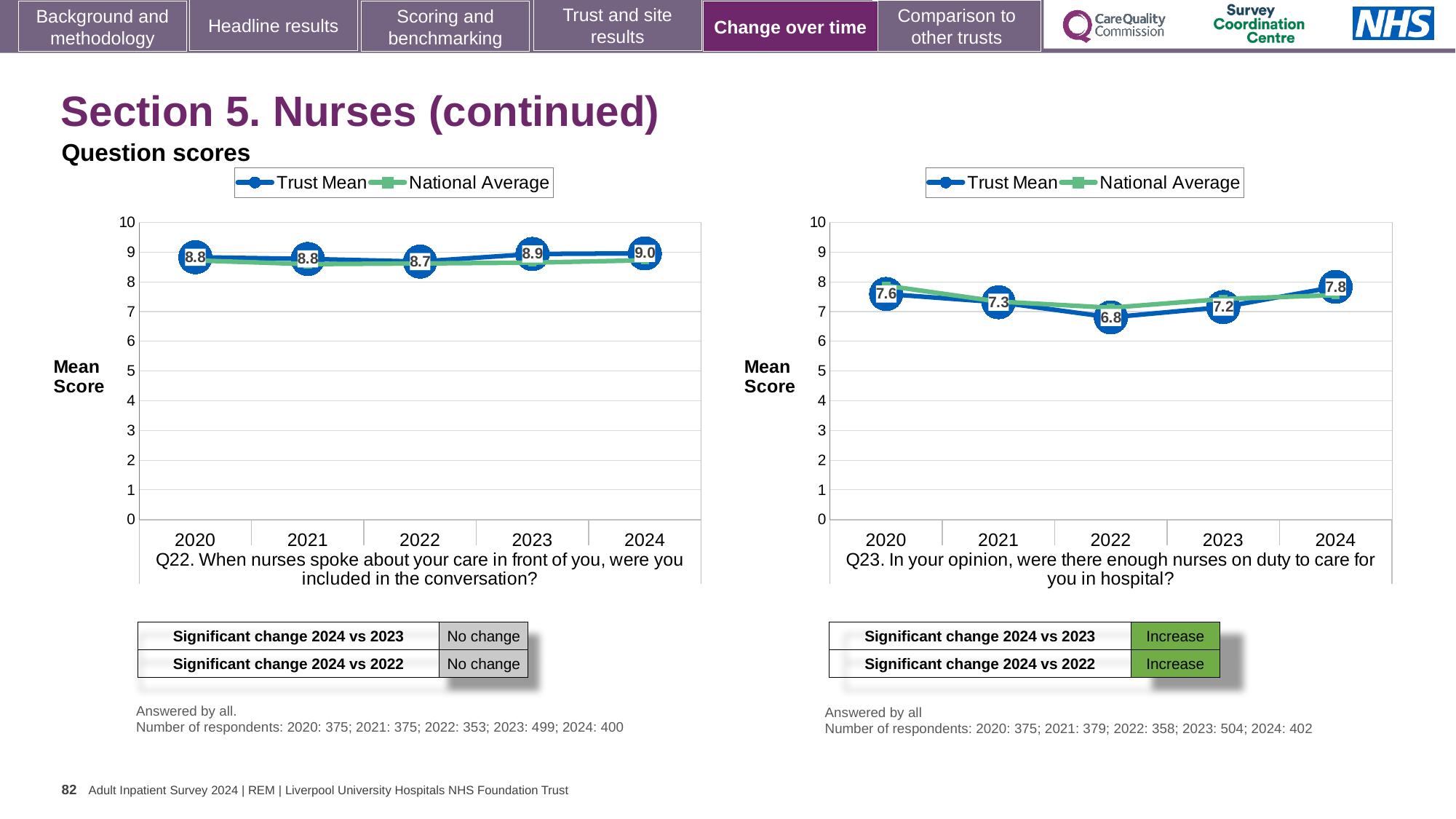
What type of chart is used for Q22 on the left? Line chart In the Q23 chart on the right, how many series does the legend list? 2 In the Q23 chart on the right, which year has the highest Trust Mean score? 2024 In the Q23 chart on the right, what is the Trust Mean score for 2022? 6.8 In the Q22 chart on the left, is the Trust Mean score for 2024 greater or less than 8? greater In the Q22 chart on the left, how many years are plotted on the x axis? 5 In the Q22 chart on the left, what is the Trust Mean score for 2022? 8.7 In the Q22 chart on the left, what is the Trust Mean score for 2024? 9.0 In the Q23 chart on the right, which year has the lowest Trust Mean score? 2022 In the Q23 chart on the right, what is the difference between the Trust Mean scores for 2024 and 2022? 1.0 In the Q23 chart on the right, what is the Trust Mean score for 2024? 7.8 In the Q23 chart on the right, does the Trust Mean rise or fall from 2022 to 2024? Rise